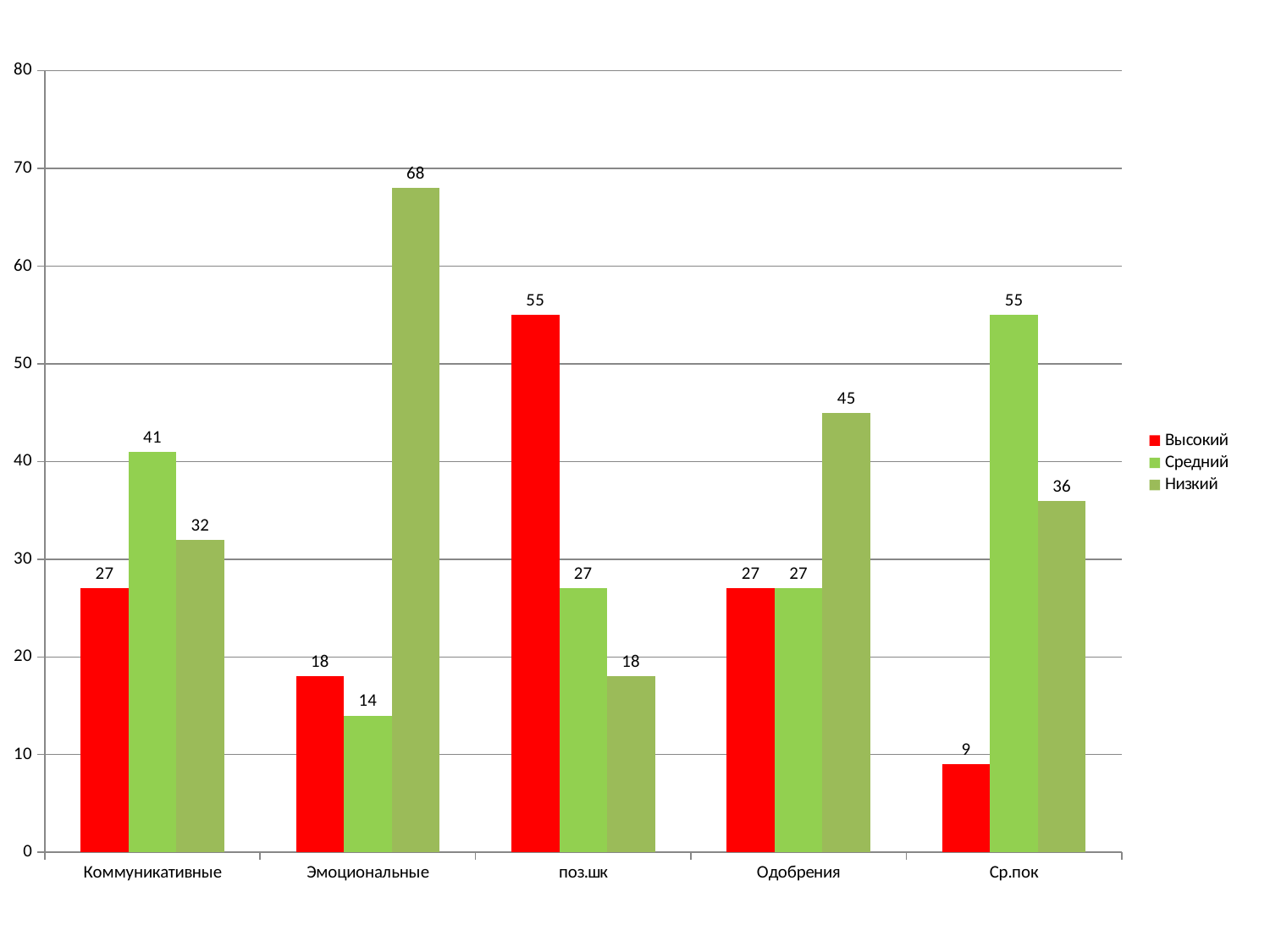
What is the value for Средний in the Ср.пок category? 55 What colour represents the Высокий series? red Which is larger in the Одобрения category: Низкий or Средний? Низкий What is the difference between the Низкий and Средний values in the Эмоциональные category? 54 What kind of chart is shown on the slide? bar chart How many categories are shown on the x axis? 5 How many series does the legend list? 3 What is the value for Низкий in the Эмоциональные category? 68 What is the value for Высокий in the поз.шк category? 55 Is the value for Средний in the Коммуникативные category greater or less than 40? greater Which category has the highest value for Низкий? Эмоциональные Which category has the lowest value for Высокий? Ср.пок